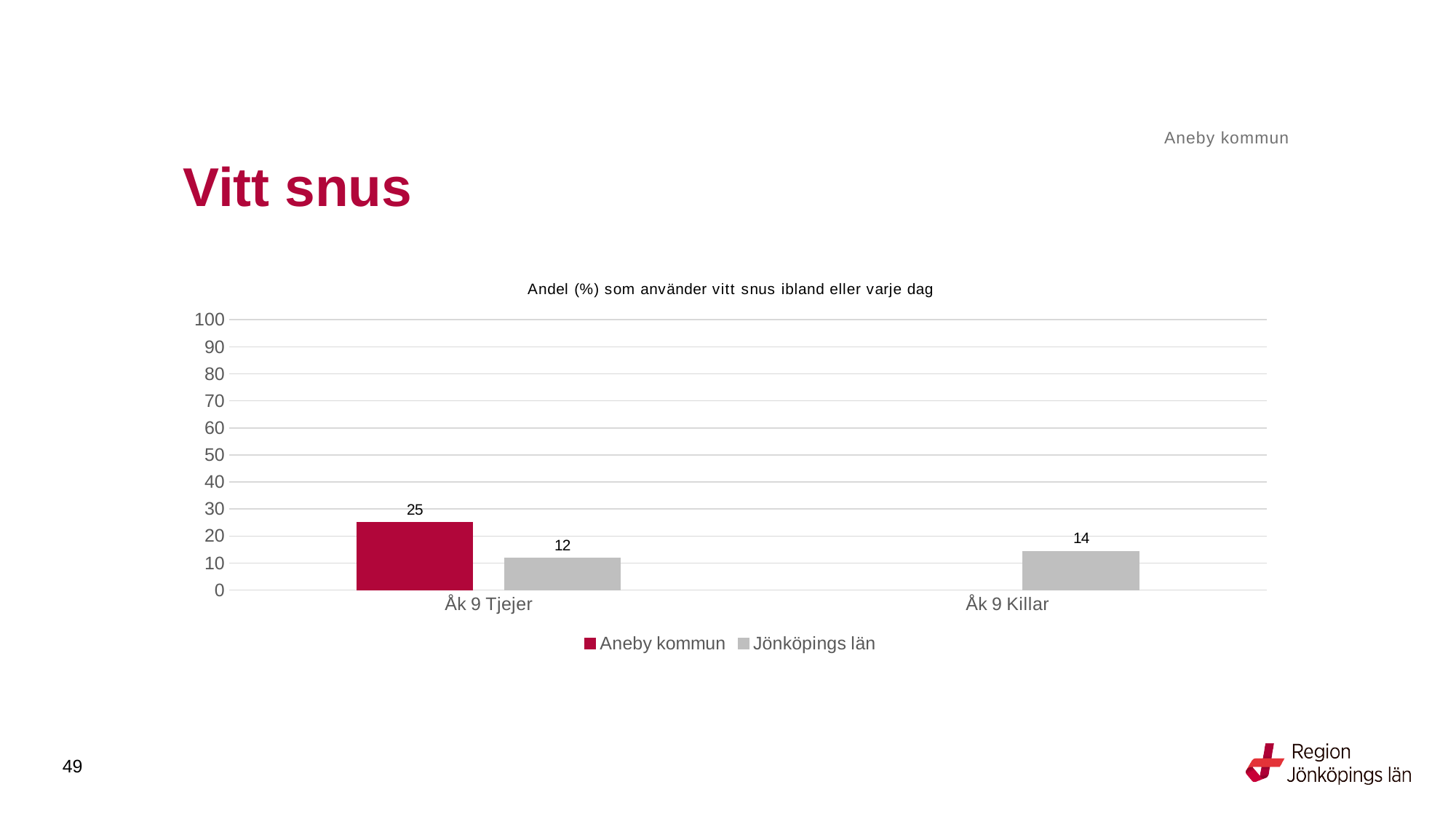
How many series does the legend list? 2 For Åk 9 Tjejer, which is larger: Aneby kommun or Jönköpings län? Aneby kommun What is the value for Jönköpings län for Åk 9 Tjejer? 12 Is the value for Aneby kommun for Åk 9 Tjejer greater or less than 20? greater What is the value for Jönköpings län for Åk 9 Killar? 14 What is the difference between the Jönköpings län values for Åk 9 Killar and Åk 9 Tjejer? 2 Which series has the highest value in the chart? Aneby kommun What is the value for Aneby kommun for Åk 9 Tjejer? 25 What kind of chart is shown on the slide? bar chart What is the difference between Aneby kommun and Jönköpings län for Åk 9 Tjejer? 13 How many categories are shown on the x axis? 2 Which bar has the lowest value in the chart? Jönköpings län for Åk 9 Tjejer